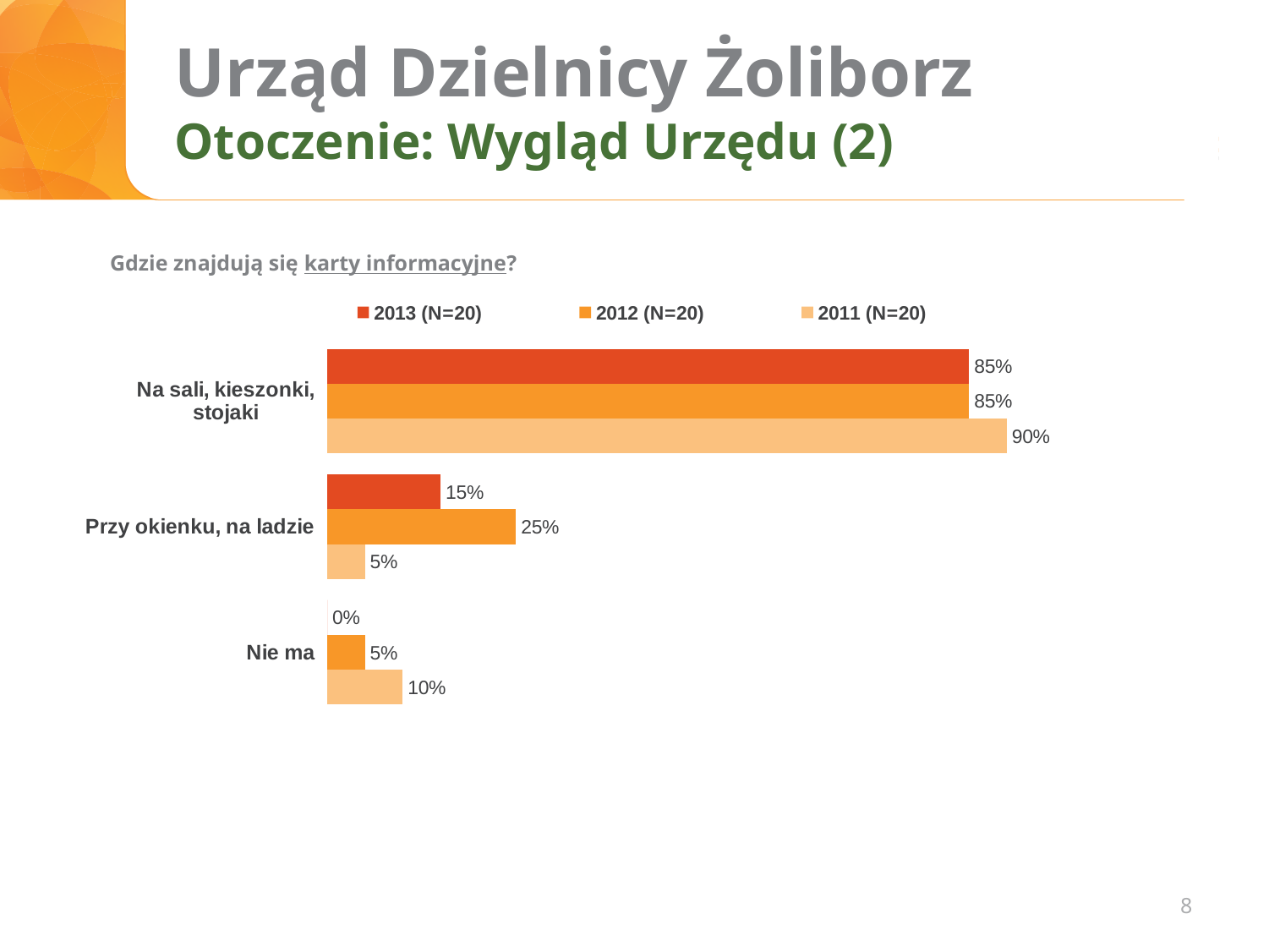
Which category has the lowest value in the 2013 (N=20) series? Nie ma What is the value for "Nie ma" in the 2013 (N=20) series? 0% How many categories are shown on the chart? 3 Which category has the highest value in the 2011 (N=20) series? Na sali, kieszonki, stojaki What is the difference between the 2011 (N=20) and 2013 (N=20) values for "Na sali, kieszonki, stojaki"? 5% What is the difference between the 2012 (N=20) and 2011 (N=20) values for "Przy okienku, na ladzie"? 20% What is the value for "Na sali, kieszonki, stojaki" in the 2013 (N=20) series? 85% What kind of chart is shown on the slide? Bar chart What is the value for "Nie ma" in the 2011 (N=20) series? 10% What is the value for "Przy okienku, na ladzie" in the 2012 (N=20) series? 25% Which is larger for "Przy okienku, na ladzie": the 2013 (N=20) value or the 2012 (N=20) value? 2012 (N=20) How many series does the legend list? 3